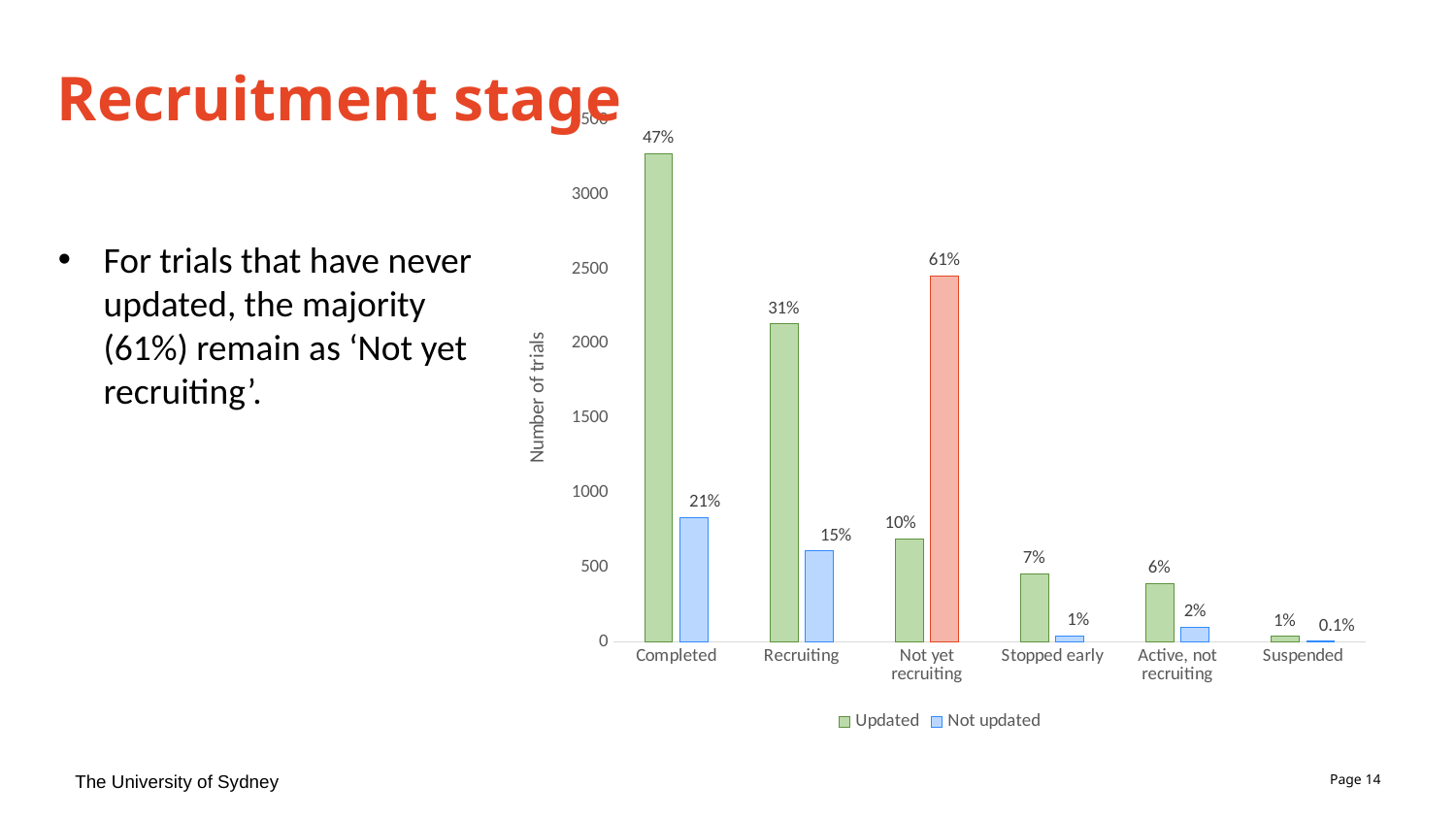
Which category has the shortest Updated bar? Suspended What is the difference in percentage labels between the Updated bars for Completed (47%) and Recruiting (31%)? 16 percentage points Is the number of trials for the Not updated bar in Completed greater or less than 1000? less How many series does the legend list? 2 Is the number of trials for the Updated bar in Completed greater or less than 3000? greater What percentage label is shown on the Not updated bar for Not yet recruiting? 61% How many recruitment stage categories are shown on the x axis? 6 What kind of chart is shown on the slide? Bar chart What is the title of the y axis? Number of trials What percentage label is shown on the Not updated bar for Suspended? 0.1% What percentage label is shown on the Updated bar for Completed? 47% Which category has the tallest Not updated bar? Not yet recruiting